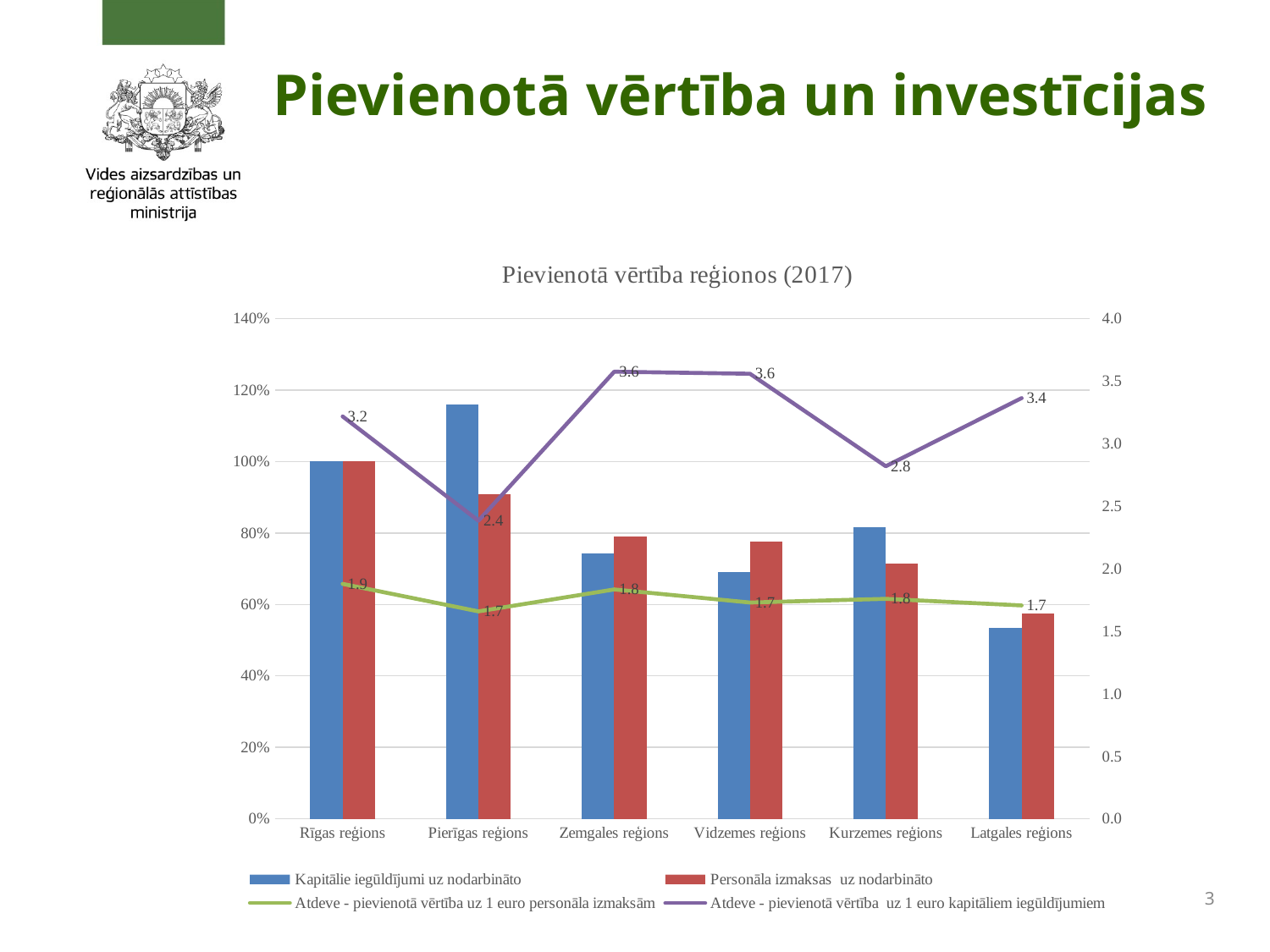
Which region has the lowest value for 'Atdeve - pievienotā vērtība uz 1 euro kapitāliem ieguldījumiem'? Pierīgas reģions Which region has the highest value for 'Atdeve - pievienotā vērtība uz 1 euro personāla izmaksām'? Rīgas reģions Which region has the larger 'Atdeve - pievienotā vērtība uz 1 euro kapitāliem ieguldījumiem' value, Kurzemes reģions or Latgales reģions? Latgales reģions How many series does the chart legend list? 4 How many regions are shown on the x axis of the chart? 6 Is the 'Kapitālie ieguldījumi uz nodarbināto' value for Pierīgas reģions greater or less than 100%? greater What is the value of 'Kapitālie ieguldījumi uz nodarbināto' for Rīgas reģions? 100% What is the difference between the 'Atdeve - pievienotā vērtība uz 1 euro kapitāliem ieguldījumiem' values for Zemgales reģions and Pierīgas reģions? 1.2 What is the value of 'Atdeve - pievienotā vērtība uz 1 euro kapitāliem ieguldījumiem' for Zemgales reģions? 3.6 What is the value of 'Atdeve - pievienotā vērtība uz 1 euro personāla izmaksām' for Rīgas reģions? 1.9 Is the 'Kapitālie ieguldījumi uz nodarbināto' value for Latgales reģions greater or less than 60%? less Which region has the highest 'Kapitālie ieguldījumi uz nodarbināto' bar? Pierīgas reģions